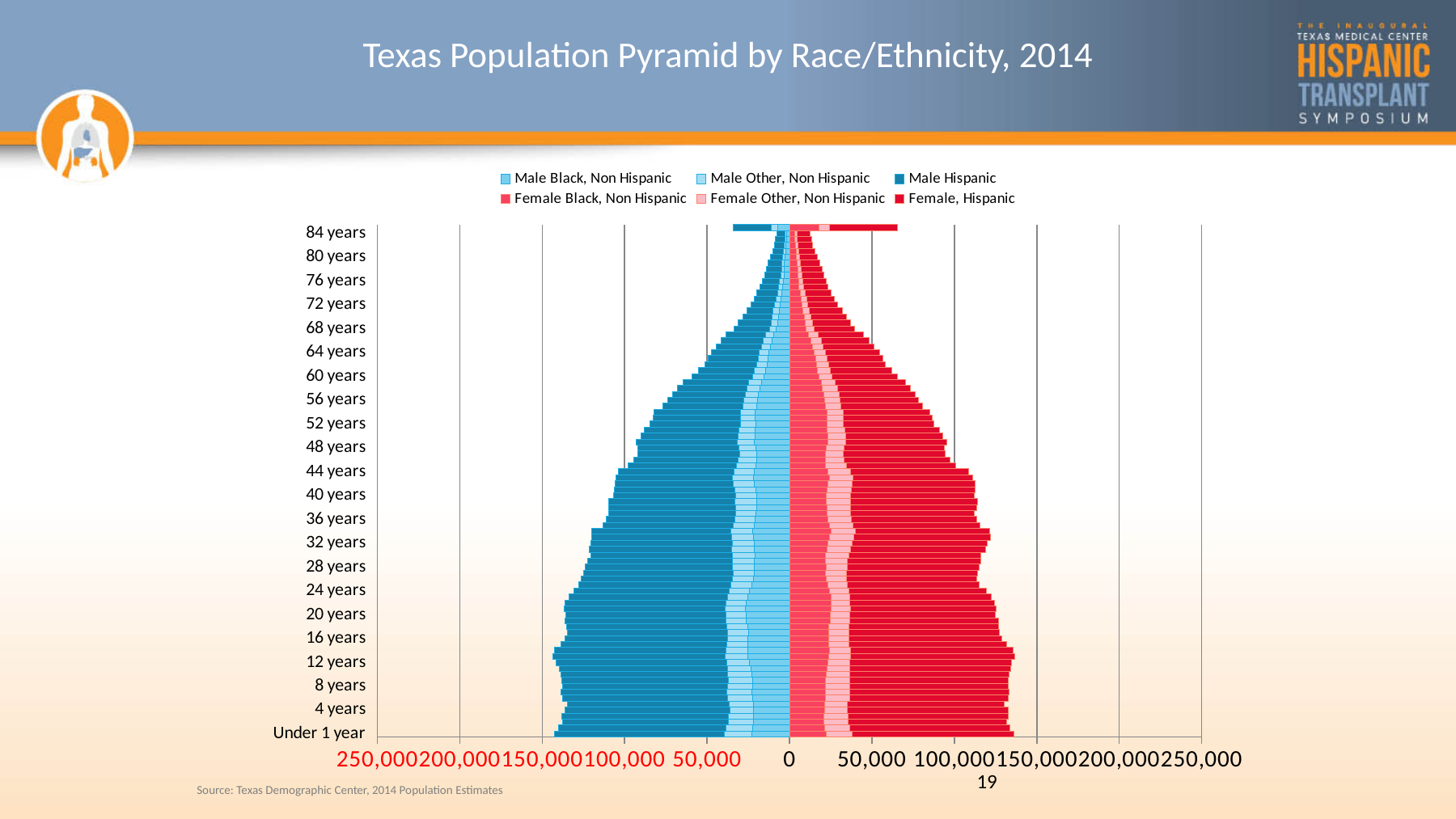
Is the total female population at 12 years greater or less than 100,000? greater Is the total male population at 12 years greater or less than 100,000? greater Is the total male population at 76 years greater or less than 50,000? less Which age group has a larger total female population, 36 years or 72 years? 36 years Which age group has a larger total male population, 12 years or 60 years? 12 years Which colour family is used for the female series in the chart? Red/pink What is the title of the chart? Texas Population Pyramid by Race/Ethnicity, 2014 What is the highest value shown on the horizontal axis? 250,000 How many series does the legend list? 6 Moving up the vertical axis from Under 1 year to 84 years, do the total bar lengths generally increase or decrease? Decrease What type of chart is shown on the slide? Bar chart (population pyramid)